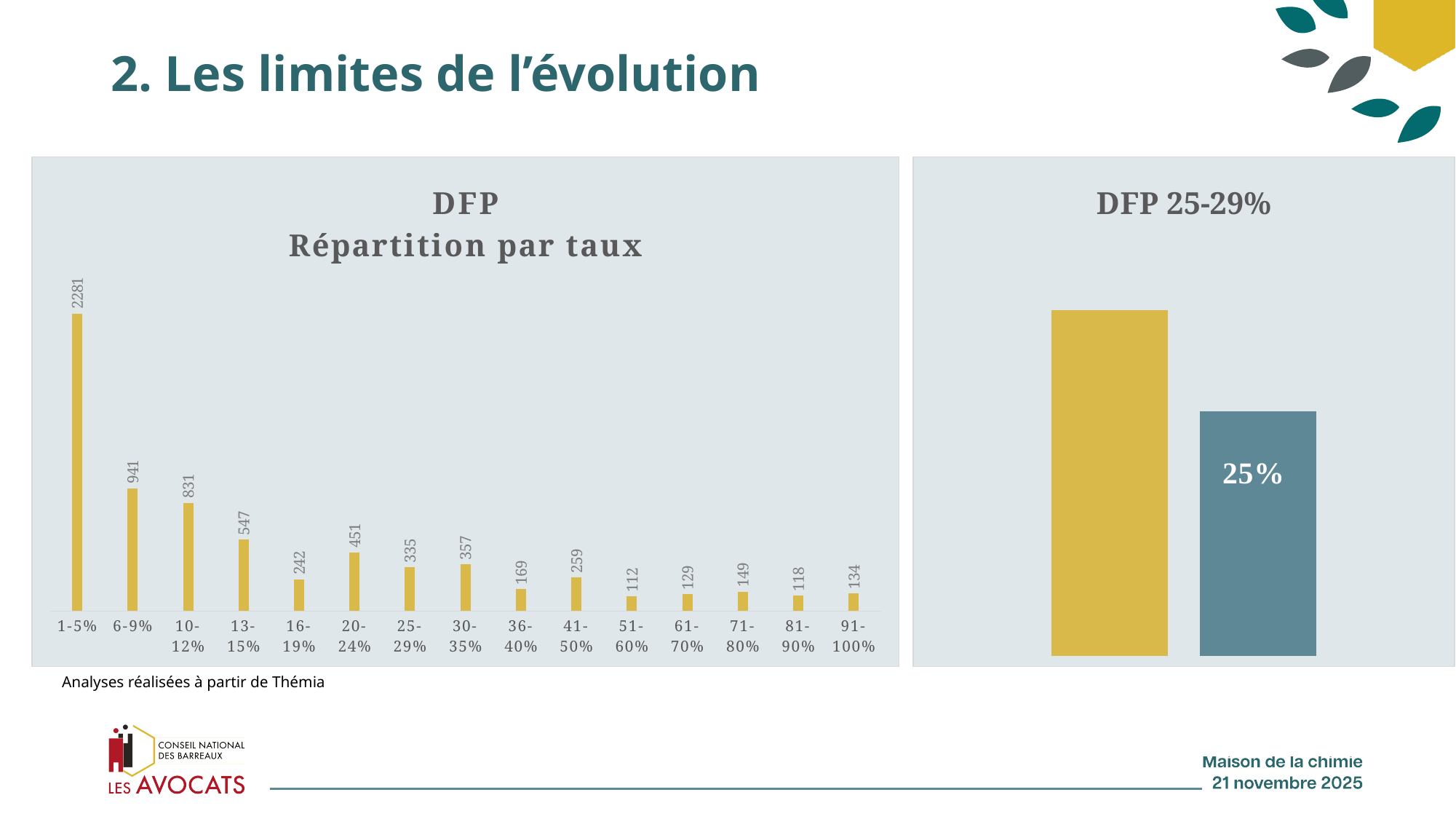
In the chart titled "DFP Répartition par taux", what is the value for the 91-100% category? 134 In the chart titled "DFP Répartition par taux", which category has the highest value? 1-5% In the chart titled "DFP Répartition par taux", what is the difference between the values for 6-9% and 10-12%? 110 In the chart titled "DFP Répartition par taux", what is the value for the 1-5% category? 2281 In the chart titled "DFP 25-29%", how many bars are shown? 2 In the chart titled "DFP Répartition par taux", how many categories are shown on the x axis? 15 In the chart titled "DFP Répartition par taux", do the values generally rise or fall from 1-5% to 16-19%? Fall In the chart titled "DFP Répartition par taux", what is the value for the 25-29% category? 335 What kind of chart is the chart titled "DFP Répartition par taux"? Bar chart In the chart titled "DFP Répartition par taux", which is larger, the value for 20-24% or the value for 30-35%? 20-24% In the chart titled "DFP Répartition par taux", which category has the lowest value? 51-60% In the chart titled "DFP 25-29%", what label is printed on the blue bar? 25%